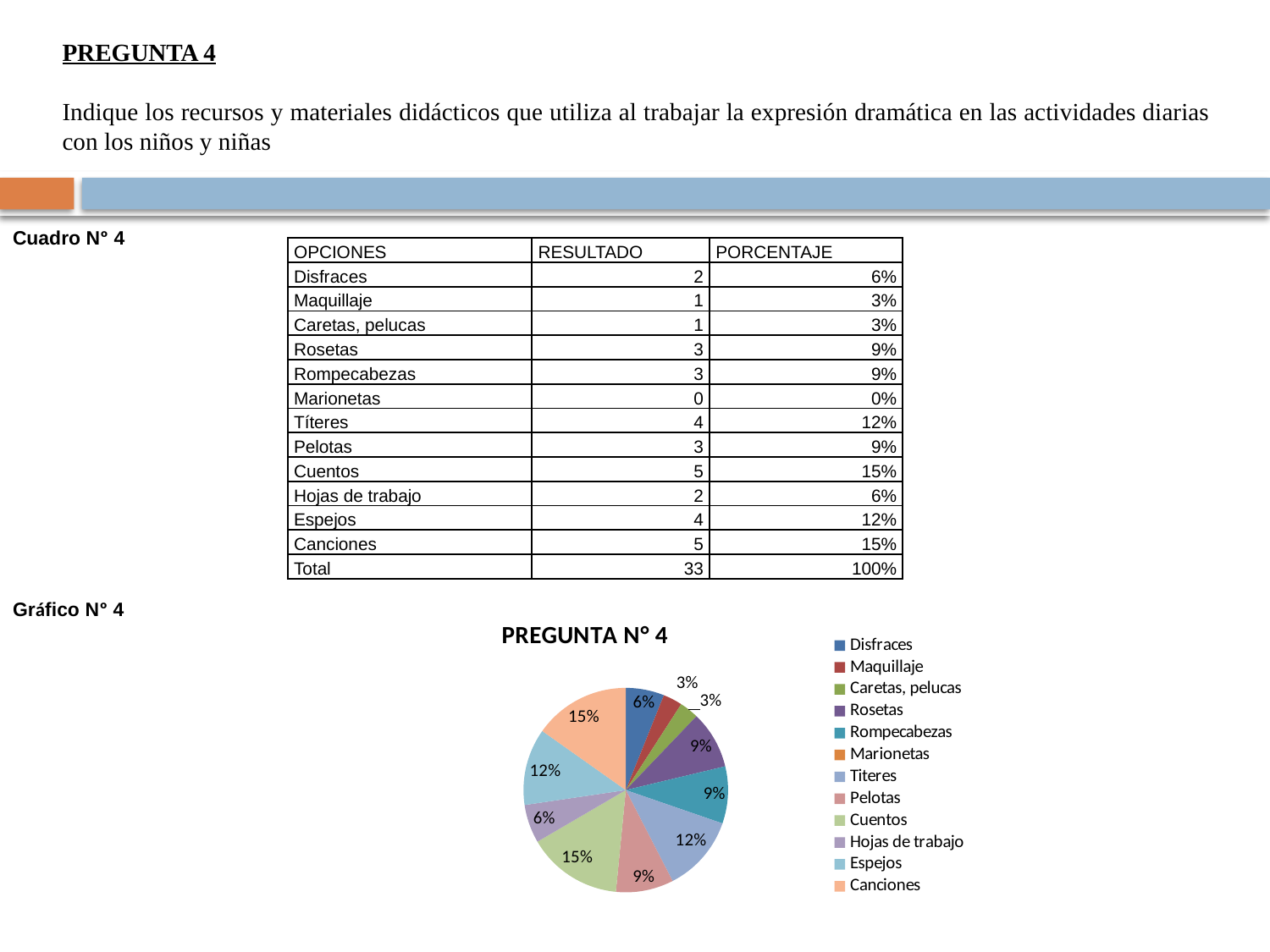
How many entries does the legend of the pie chart list? 12 In the pie chart, what share does the Cuentos slice represent? 15% In the pie chart, what percentage is shown for the Canciones slice? 15% In the pie chart, what is the difference in percentage points between the Canciones slice and the Hojas de trabajo slice? 9% In the pie chart, what percentage is shown for the Disfraces slice? 6% What kind of chart is shown under "Gráfico N° 4"? pie chart In the pie chart, which slice is larger: Cuentos or Disfraces? Cuentos In the pie chart, what is the difference in percentage points between the Rosetas slice and the Caretas, pelucas slice? 6% What is the title of the pie chart? PREGUNTA N° 4 In the pie chart, what percentage is shown for the Maquillaje slice? 3% In the pie chart, what percentage is shown for the Títeres slice? 12% In the pie chart, which slice is larger: Espejos or Maquillaje? Espejos